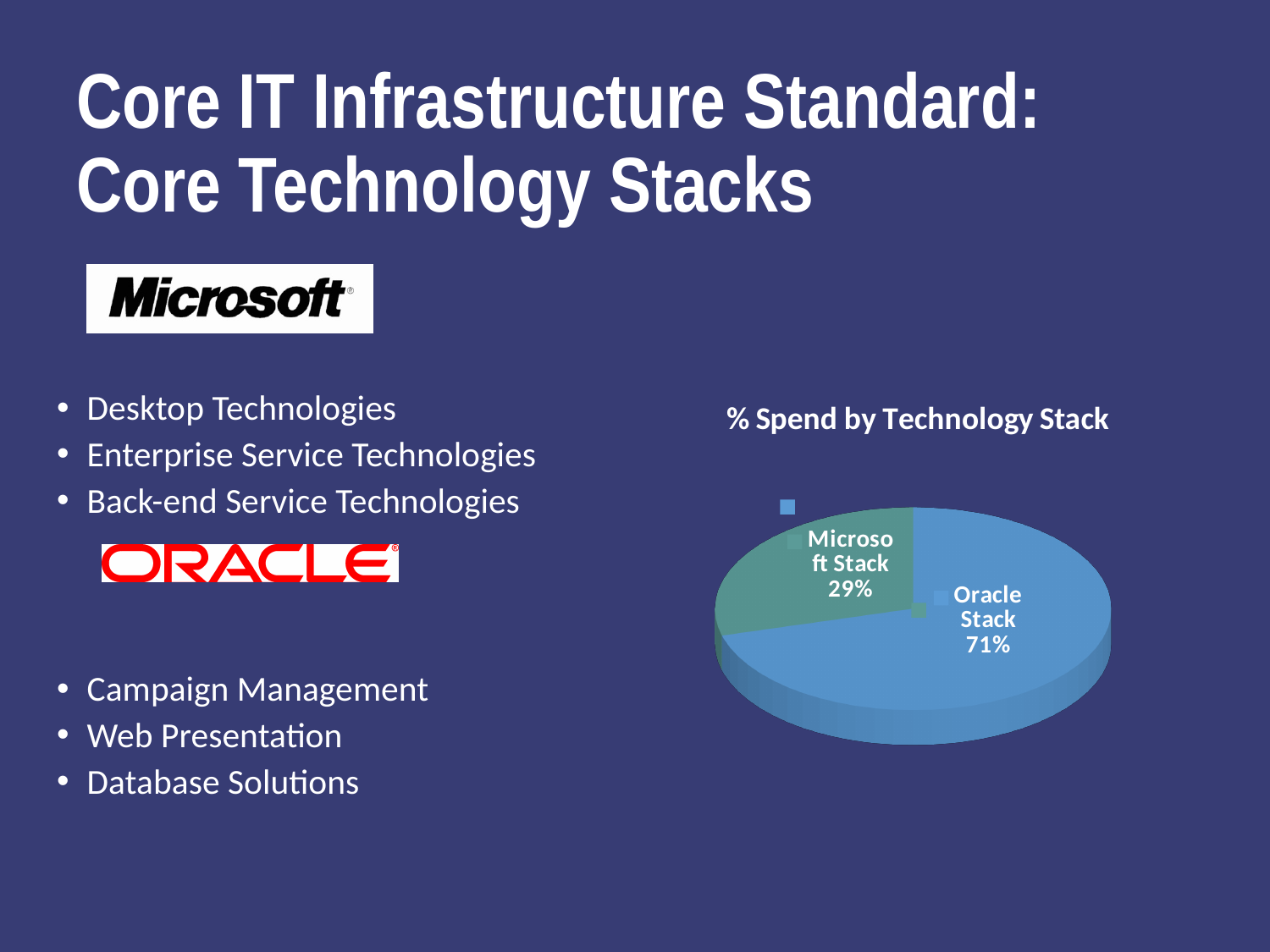
What is the title of the chart? % Spend by Technology Stack What is the difference in percentage points between the Oracle Stack and Microsoft Stack shares? 42 Which technology stack has the smallest share of spend? Microsoft Stack What kind of chart is shown on the slide? pie chart What share of spend does the Microsoft Stack account for? 29% Which technology stack has the largest share of spend? Oracle Stack Which has a larger share of spend, the Oracle Stack or the Microsoft Stack? Oracle Stack What colour is the Oracle Stack slice? blue What share of spend does the Oracle Stack account for? 71% How many slices does the pie chart have? 2